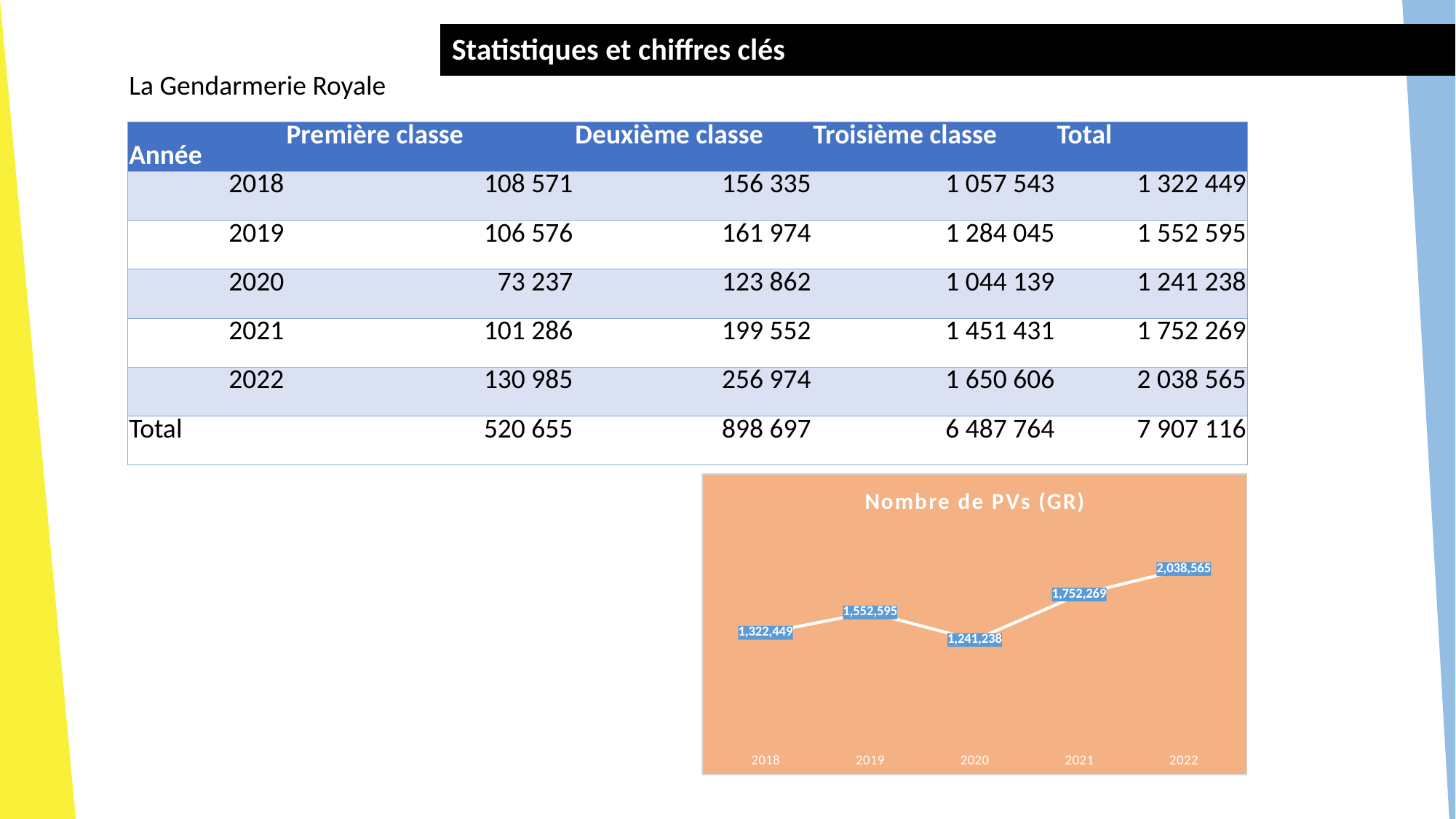
What is the title of the chart on the slide? Nombre de PVs (GR) What type of chart is shown on the slide? Line chart In the chart 'Nombre de PVs (GR)', what is the difference between the values for 2019 and 2020? 311,357 In the chart 'Nombre de PVs (GR)', what is the value for 2022? 2,038,565 In the chart 'Nombre de PVs (GR)', which year has the highest value? 2022 In the chart 'Nombre de PVs (GR)', which is larger, the value for 2019 or the value for 2021? 2021 In the chart 'Nombre de PVs (GR)', what is the value for 2018? 1,322,449 In the chart 'Nombre de PVs (GR)', does the value rise or fall from 2020 to 2022? Rise In the chart 'Nombre de PVs (GR)', which year has the lowest value? 2020 In the chart 'Nombre de PVs (GR)', what is the difference between the values for 2022 and 2021? 286,296 How many data points are plotted in the chart 'Nombre de PVs (GR)'? 5 In the chart 'Nombre de PVs (GR)', what is the value for 2020? 1,241,238